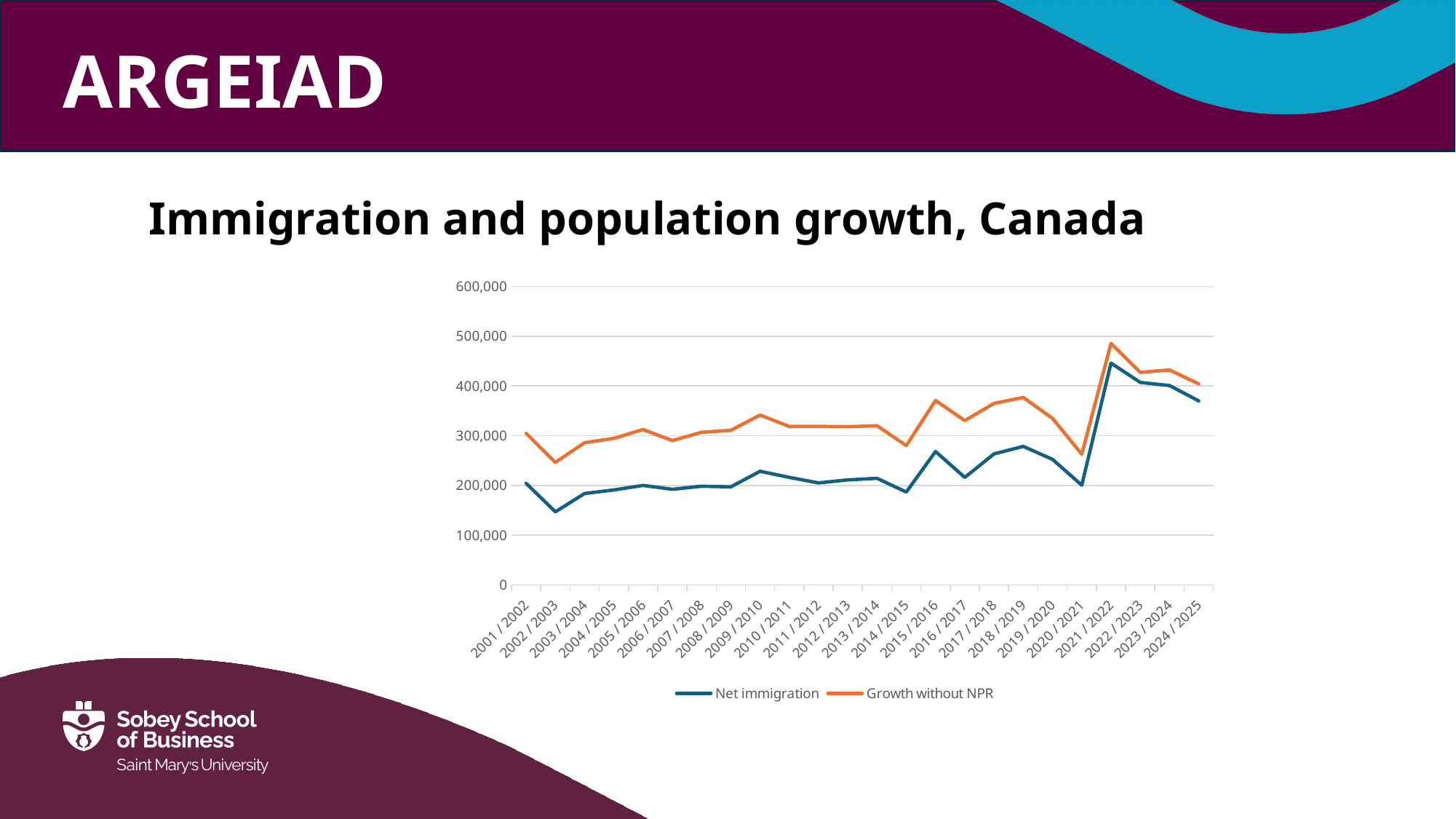
How many series does the legend list? 2 How many periods are plotted along the x axis? 24 Is the value for Net immigration in 2021 / 2022 greater or less than 400,000? greater What kind of chart is shown on the slide? Line chart In which period does Net immigration reach its highest value? 2021 / 2022 Is the value for Net immigration in 2002 / 2003 greater or less than 200,000? less In 2010 / 2011, which series has the higher value, Net immigration or Growth without NPR? Growth without NPR In which period does Growth without NPR reach its highest value? 2021 / 2022 What is the title of the chart? Immigration and population growth, Canada In which period is Net immigration at its lowest? 2002 / 2003 Does Net immigration rise or fall from 2020 / 2021 to 2021 / 2022? Rise Is the value for Growth without NPR in 2015 / 2016 greater or less than 300,000? greater